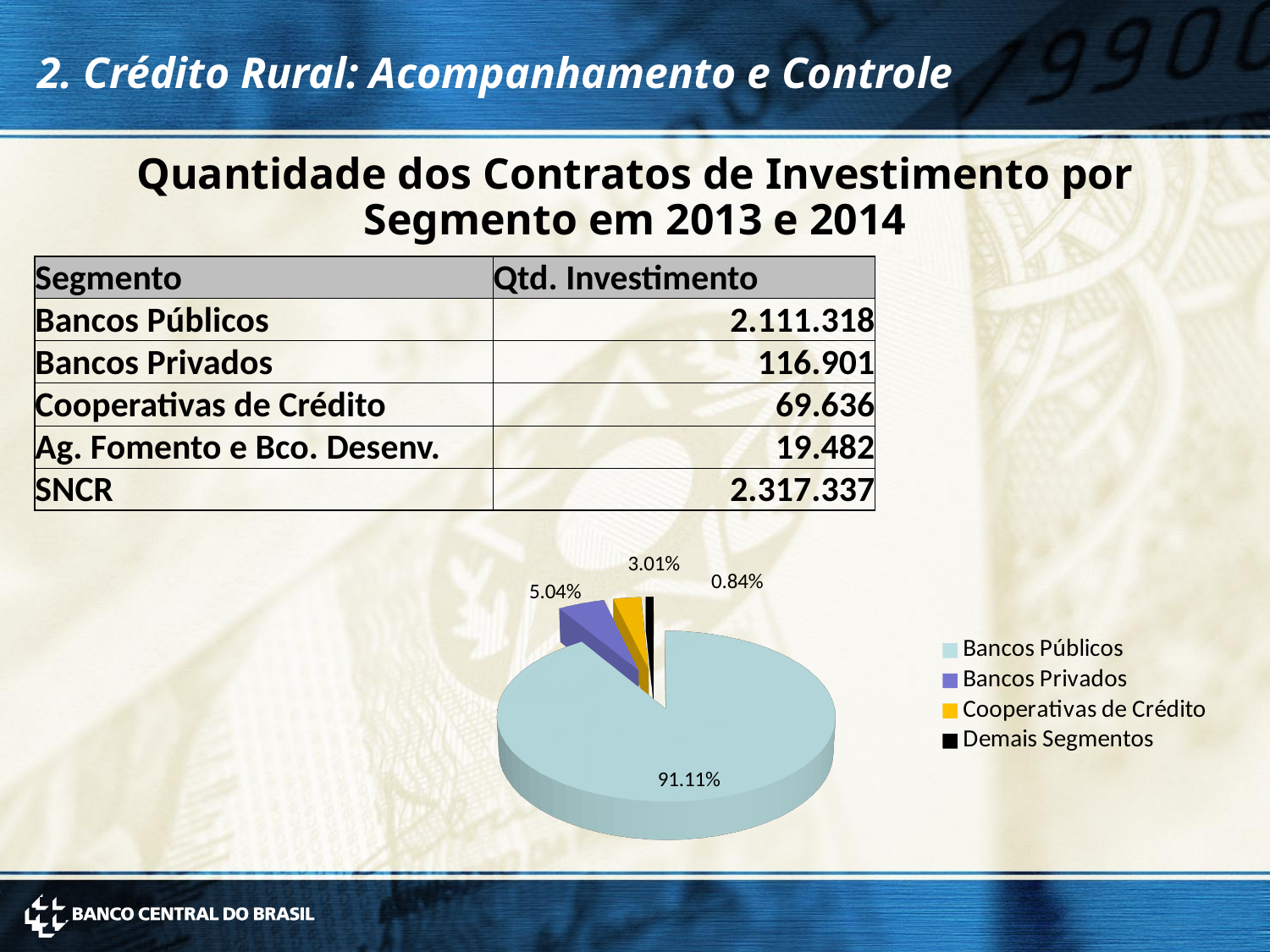
What kind of chart is shown on the slide? pie chart How many slices does the pie chart have? 4 What share of the pie chart does Demais Segmentos hold? 0.84% Which segment has the largest slice in the pie chart? Bancos Públicos Which segment has the smallest slice in the pie chart? Demais Segmentos What is the difference in percentage points between the Bancos Privados slice and the Cooperativas de Crédito slice? 2.03% How many entries does the pie chart legend list? 4 What share of the pie chart does Bancos Públicos hold? 91.11% What share of the pie chart does Cooperativas de Crédito hold? 3.01% What colour is the Demais Segmentos slice in the pie chart? black Which slice is larger in the pie chart, Bancos Privados or Cooperativas de Crédito? Bancos Privados